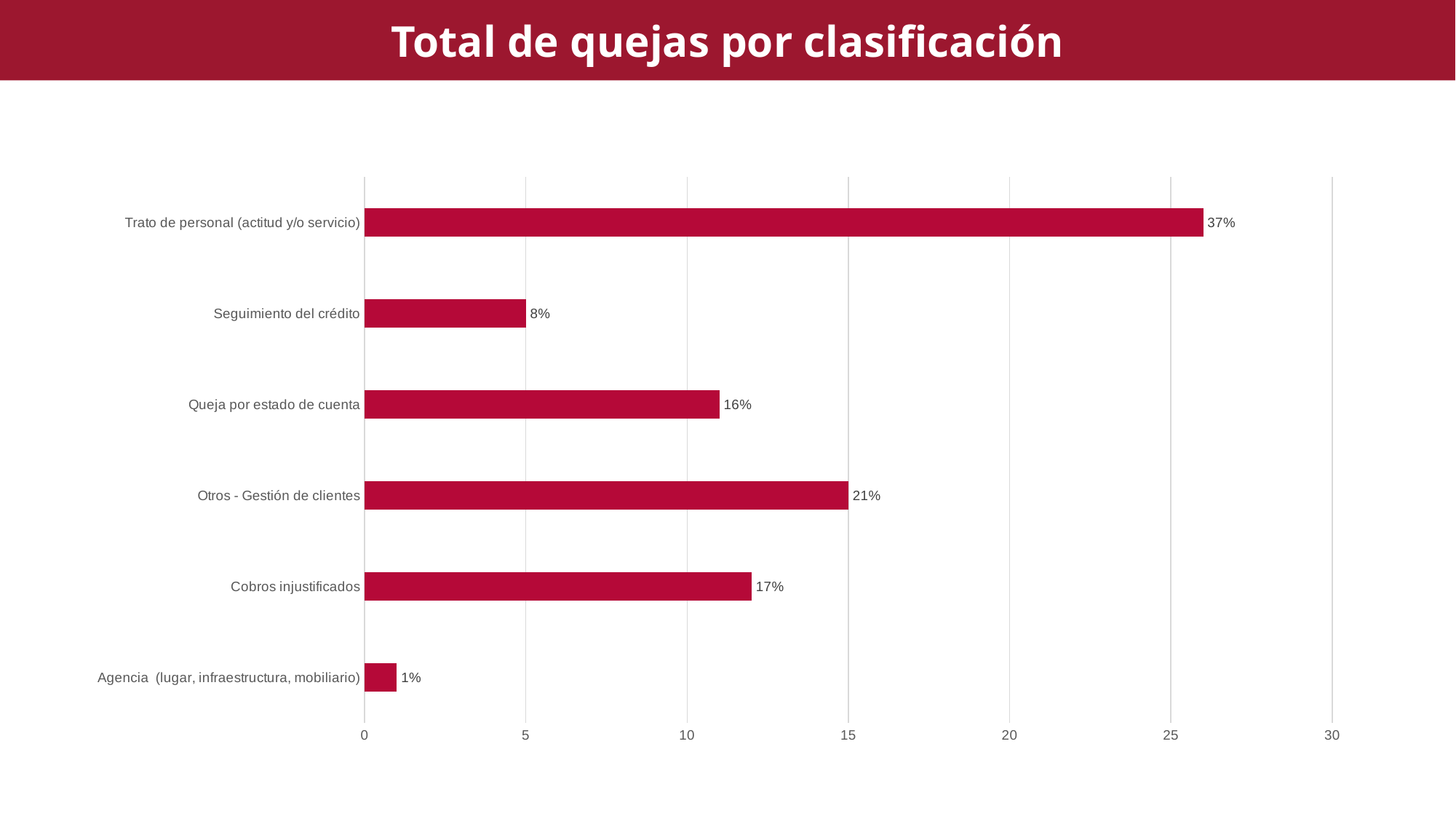
How many categories are shown in the chart? 6 What percentage label is shown for Agencia (lugar, infraestructura, mobiliario)? 1% What is the difference in percentage points between the labels for Cobros injustificados and Queja por estado de cuenta? 1% Is the value for Trato de personal (actitud y/o servicio) greater or less than 25 on the axis? greater What percentage label is shown for Otros - Gestión de clientes? 21% Which category has the lowest value? Agencia (lugar, infraestructura, mobiliario) What kind of chart is shown on the slide? bar chart Which category has the highest value? Trato de personal (actitud y/o servicio) What percentage label is shown for Trato de personal (actitud y/o servicio)? 37% Which is larger, the value for Otros - Gestión de clientes or the value for Cobros injustificados? Otros - Gestión de clientes What is the title of the chart? Total de quejas por clasificación What percentage label is shown for Seguimiento del crédito? 8%